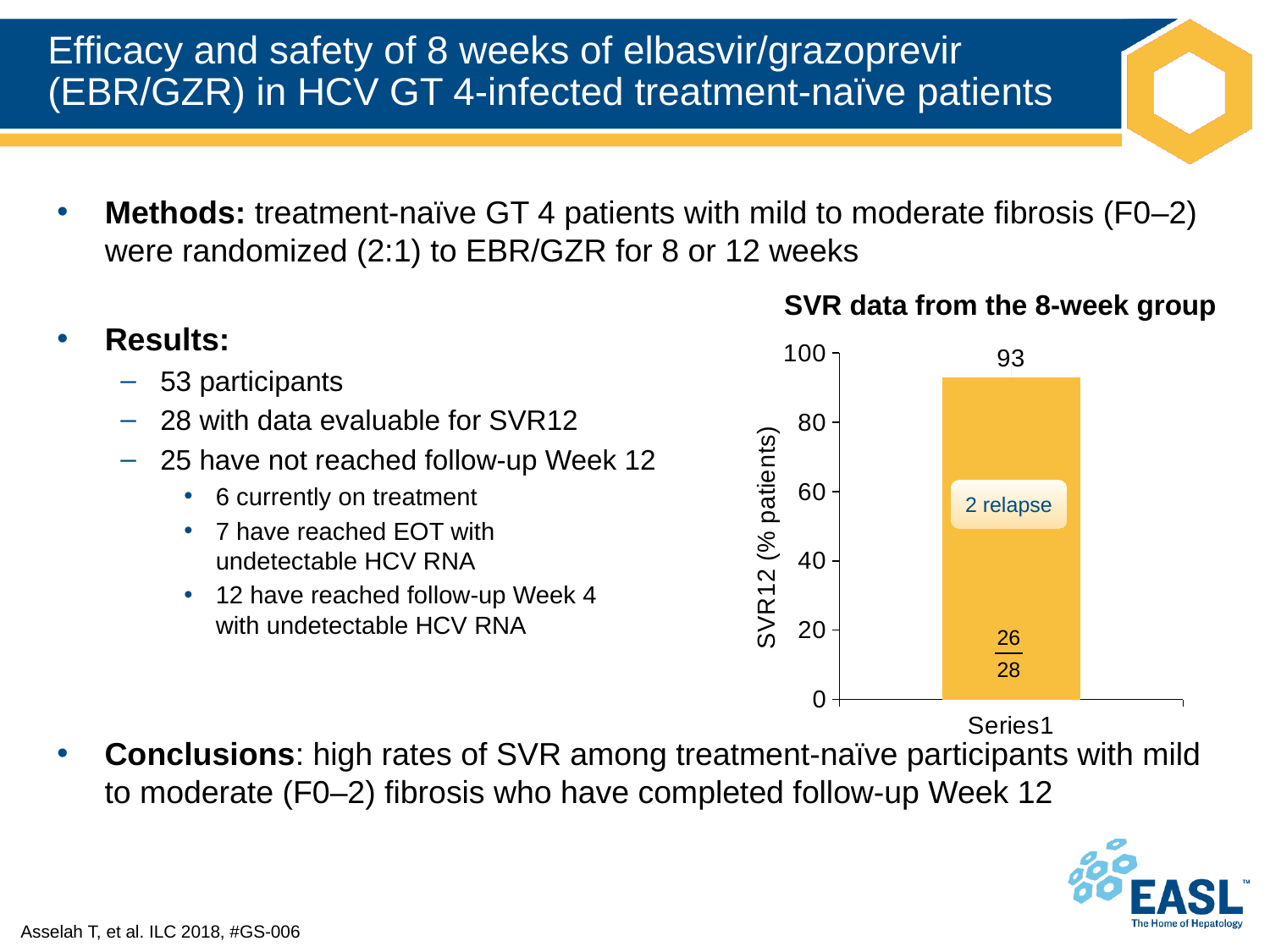
What is the maximum value shown on the y-axis of the chart? 100 What fraction is printed inside the bar in the chart? 26/28 What is the y-axis label of the chart? SVR12 (% patients) How many bars are plotted in the chart? 1 What is the title of the chart? SVR data from the 8-week group What kind of chart is shown on the slide? bar chart Is the SVR12 value for the 8-week group greater or less than 80? greater What is the category label shown on the x-axis of the chart? Series1 What is the SVR12 value shown on the bar in the chart? 93 How many relapses are noted on the bar in the chart? 2